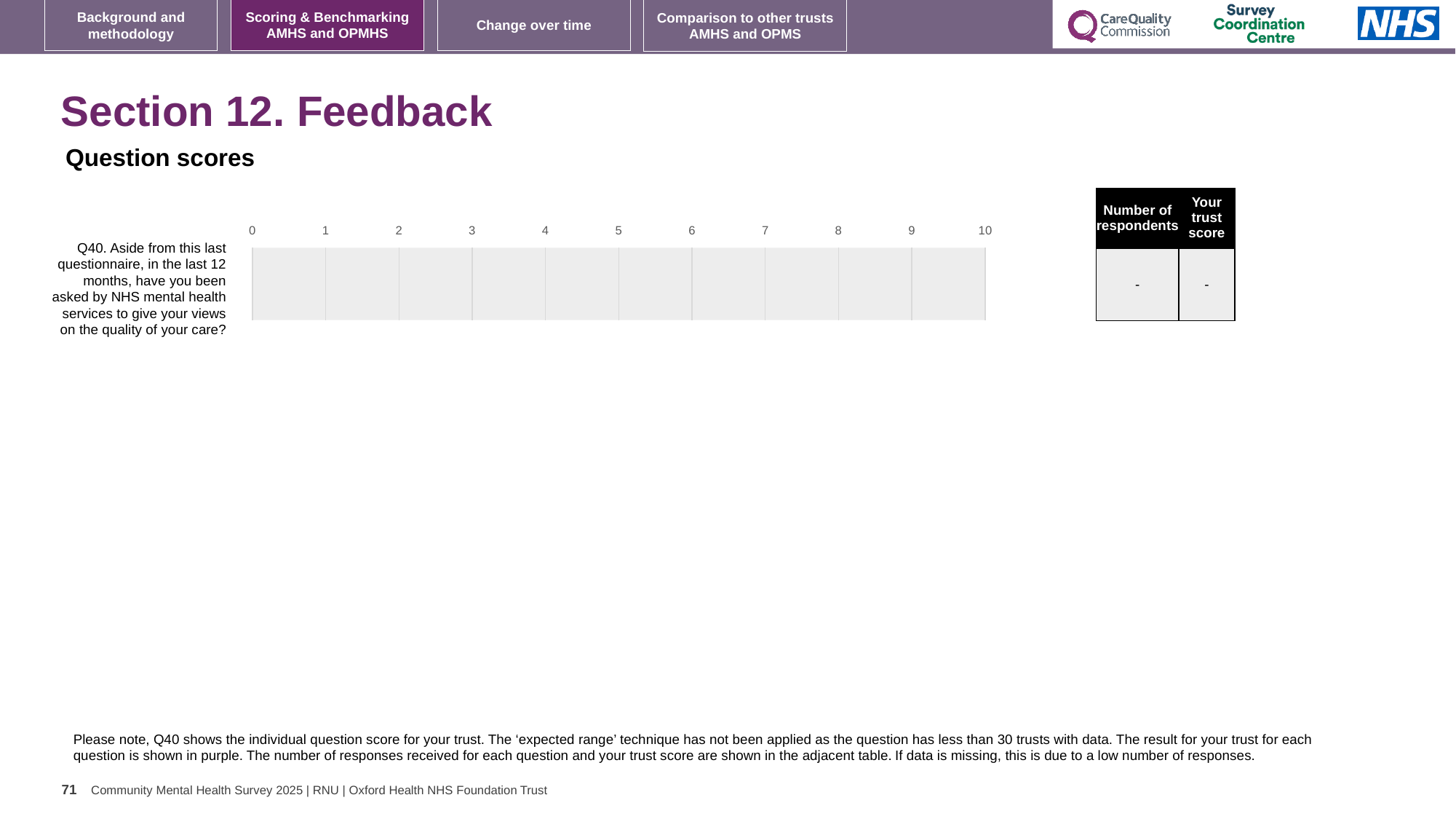
What is shown in the 'Your trust score' column of the table for Q40? - Which question number is shown on the chart? Q40 How many questions (categories) are listed on the chart? 1 What is the highest value shown on the chart's horizontal axis? 10 What is the lowest value shown on the chart's horizontal axis? 0 What is shown in the 'Number of respondents' column of the table for Q40? - Is a bar plotted for Q40 on the chart? No